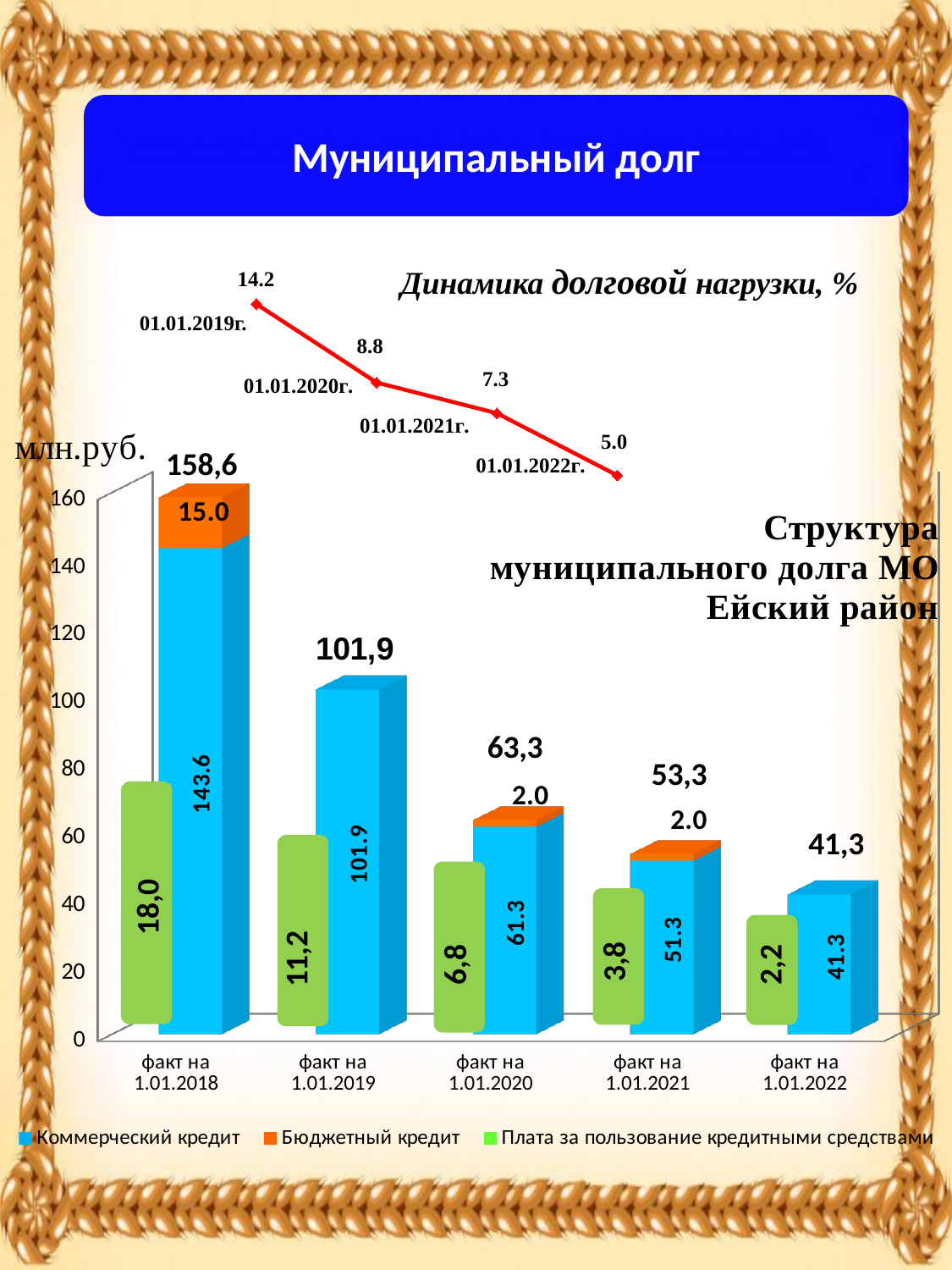
In the bar chart 'Структура муниципального долга МО Ейский район', how many series does the legend list? 3 In the line chart 'Динамика долговой нагрузки, %', how many data points are plotted? 4 In the line chart 'Динамика долговой нагрузки, %', do the values rise or fall from 01.01.2019г. to 01.01.2022г.? fall In the bar chart 'Структура муниципального долга МО Ейский район', which date has the lowest total debt? факт на 1.01.2022 In the line chart 'Динамика долговой нагрузки, %', what is the value for 01.01.2019г.? 14.2 In the bar chart 'Структура муниципального долга МО Ейский район', what is the value of Коммерческий кредит for факт на 1.01.2018? 143.6 In the line chart 'Динамика долговой нагрузки, %', what is the difference between the values for 01.01.2019г. and 01.01.2020г.? 5.4 In the bar chart 'Структура муниципального долга МО Ейский район', which colour represents Бюджетный кредит? orange In the bar chart 'Структура муниципального долга МО Ейский район', what is the value of Плата за пользование кредитными средствами for факт на 1.01.2021? 3,8 In the line chart 'Динамика долговой нагрузки, %', what is the value for 01.01.2022г.? 5.0 In the bar chart 'Структура муниципального долга МО Ейский район', what is the total municipal debt shown for факт на 1.01.2018? 158,6 In the bar chart 'Структура муниципального долга МО Ейский район', what is the value of Бюджетный кредит for факт на 1.01.2020? 2.0